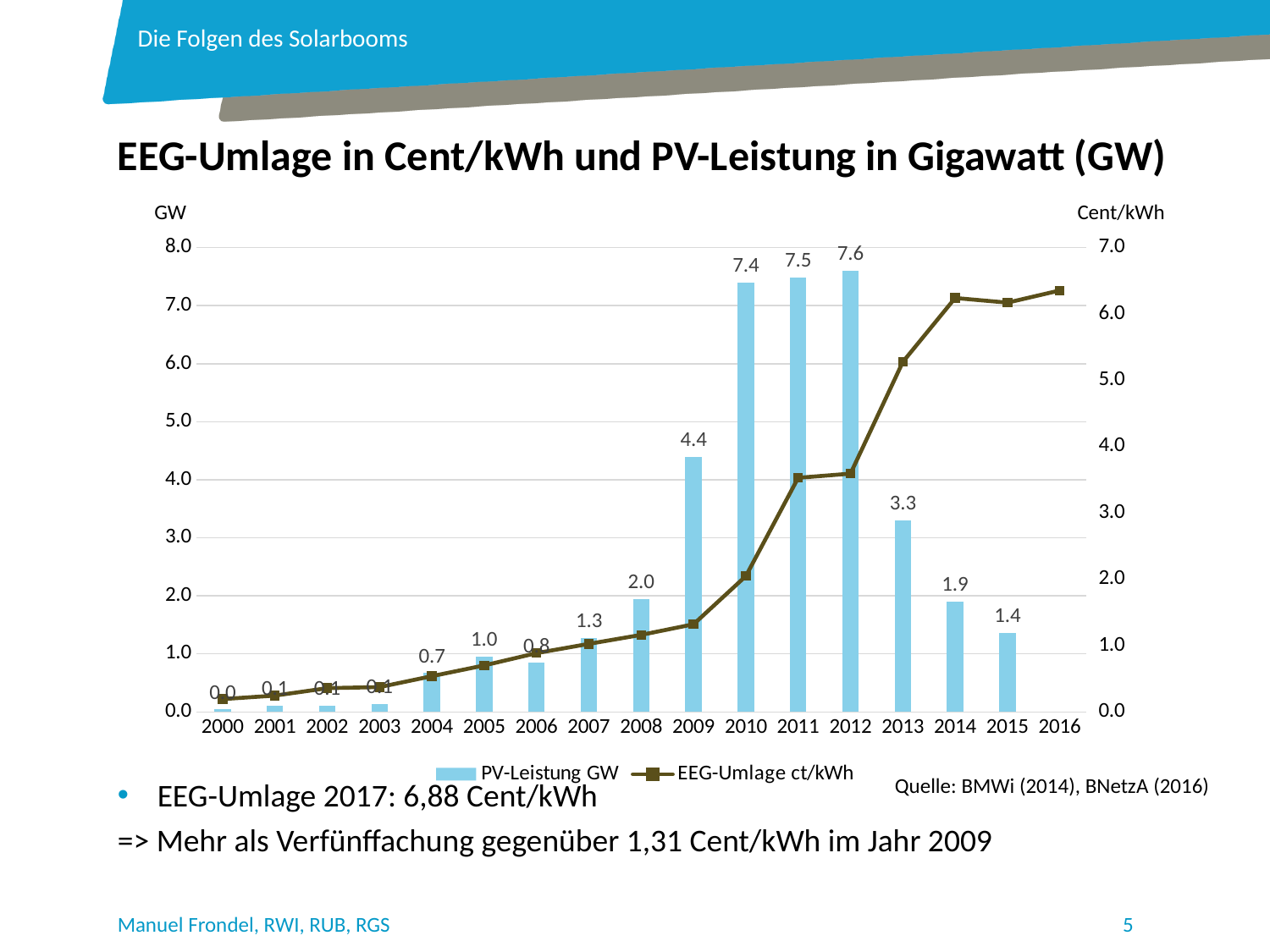
Is the EEG-Umlage value for 2012 greater or less than 3.0 Cent/kWh? greater What is the PV-Leistung in GW for 2015? 1.4 What is the difference in PV-Leistung between 2012 and 2013? 4.3 What is the PV-Leistung in GW for 2012? 7.6 How many years are shown on the x axis? 17 Which year has the larger PV-Leistung, 2010 or 2013? 2010 Does the EEG-Umlage line generally rise or fall from 2000 to 2016? Rise Is the EEG-Umlage value for 2016 greater or less than 7.0 Cent/kWh? less How many series does the legend list? 2 What is the PV-Leistung in GW for 2009? 4.4 What kind of chart is shown? Combined bar and line chart Which year has the highest PV-Leistung in GW? 2012